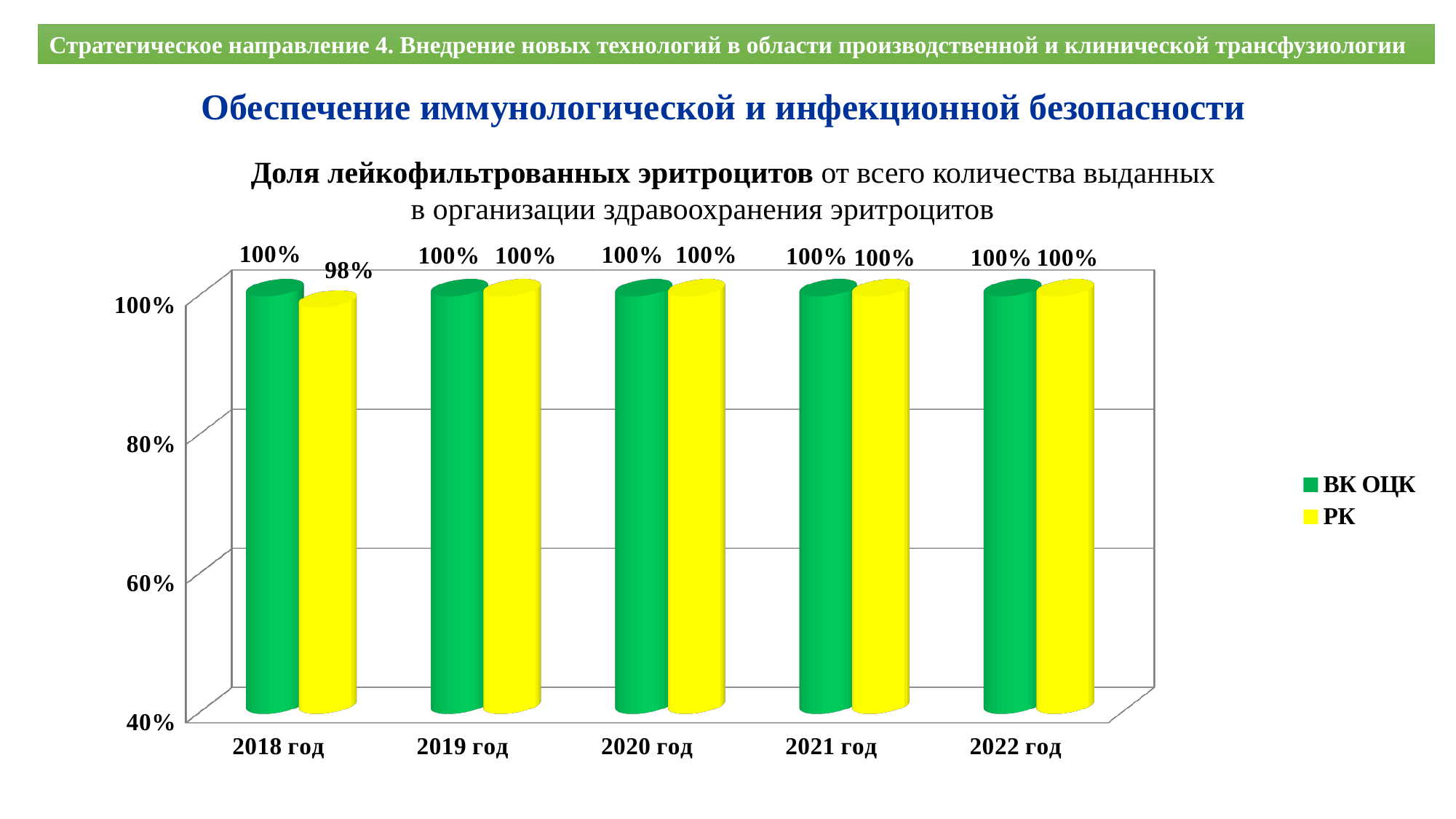
What is the value for РК in 2018 год? 98% What is the value for ВК ОЦК in 2022 год? 100% What is the difference between the ВК ОЦК and РК values in 2018 год? 2% What is the value for РК in 2020 год? 100% What is the value for ВК ОЦК in 2018 год? 100% Is the value for РК in 2018 год greater or less than 80%? greater In which year is the value for РК lowest? 2018 год Which colour represents РК in the legend? yellow In 2018 год, which series has the larger value, ВК ОЦК or РК? ВК ОЦК How many years are shown on the x axis? 5 What kind of chart is shown on the slide? bar chart How many series does the legend list? 2